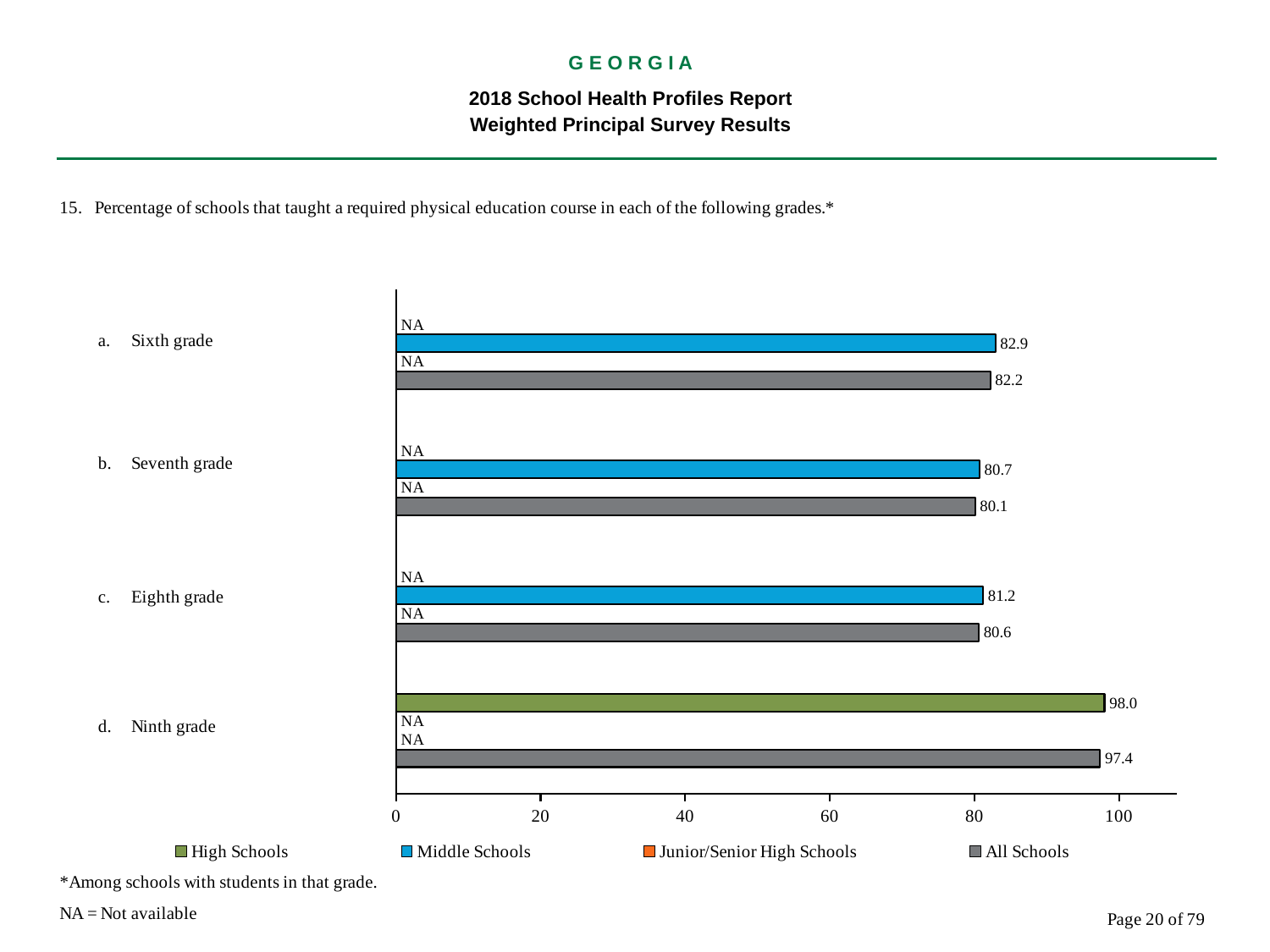
What is the value for All Schools for Seventh grade? 80.1 What is the difference between the Middle Schools value and the All Schools value for Eighth grade? 0.6 What kind of chart is shown on the slide? bar chart What is the value for Middle Schools for Sixth grade? 82.9 What is the value for High Schools for Ninth grade? 98.0 How many grade categories are shown on the chart? 4 Is the All Schools value for Ninth grade greater or less than 80? greater Which grade has the highest All Schools value? Ninth grade Which is larger for Sixth grade: the Middle Schools value or the All Schools value? Middle Schools How many series does the legend list? 4 What is the value for All Schools for Ninth grade? 97.4 Which grade has the lowest Middle Schools value? Seventh grade